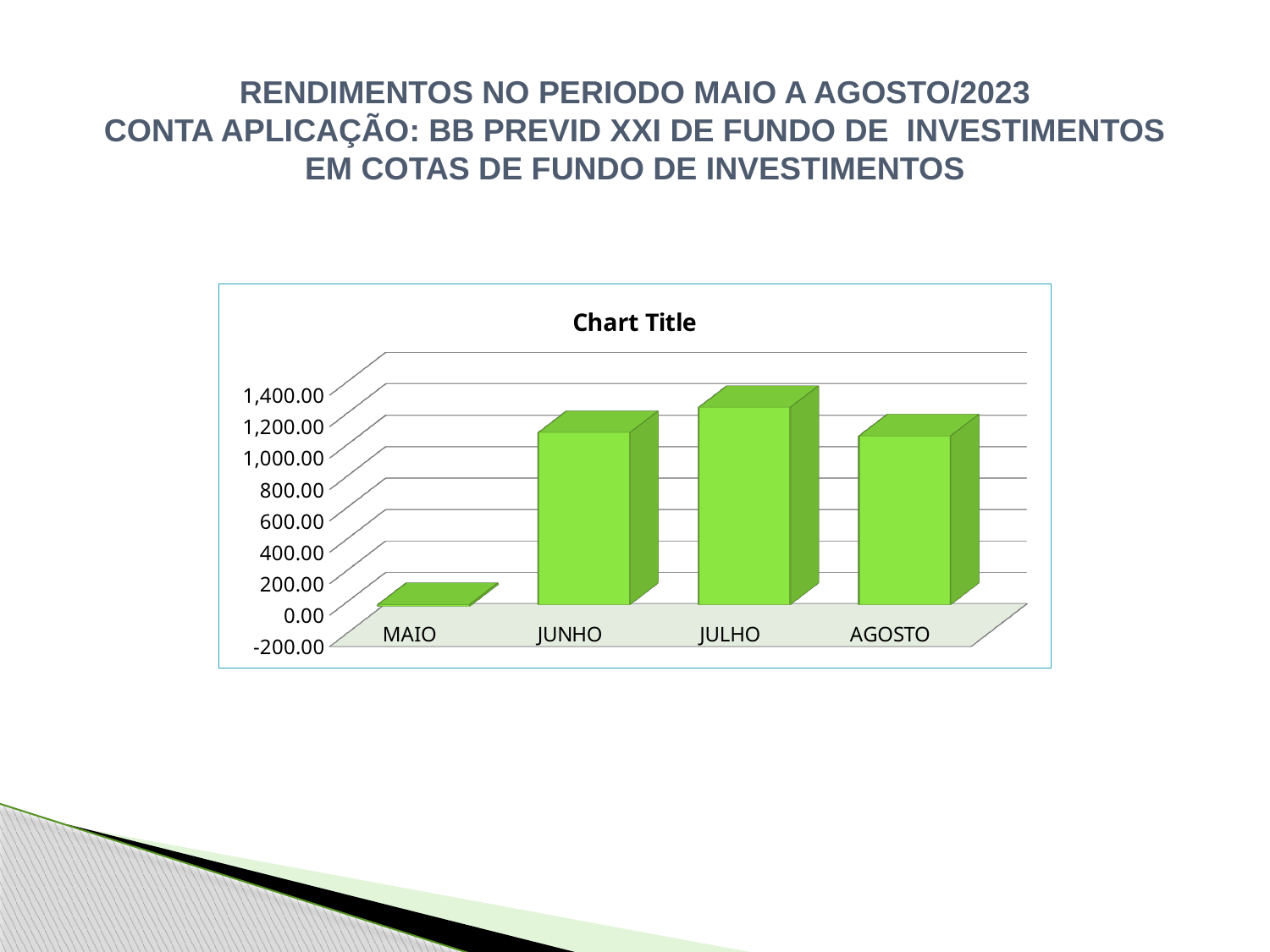
Is the value for JUNHO greater or less than 800.00? greater What is the first category label on the x axis of the chart? MAIO Is the value for JULHO greater or less than 1,000.00? greater Is the value for MAIO greater or less than 200.00? less Which is larger, the value for JULHO or the value for JUNHO? JULHO What is the title shown inside the chart area? Chart Title Which month has the lowest value in the chart? MAIO Which is larger, the value for MAIO or the value for AGOSTO? AGOSTO How many categories are plotted on the x axis of the chart? 4 What kind of chart is shown on the slide? bar chart Which month has the highest value in the chart? JULHO